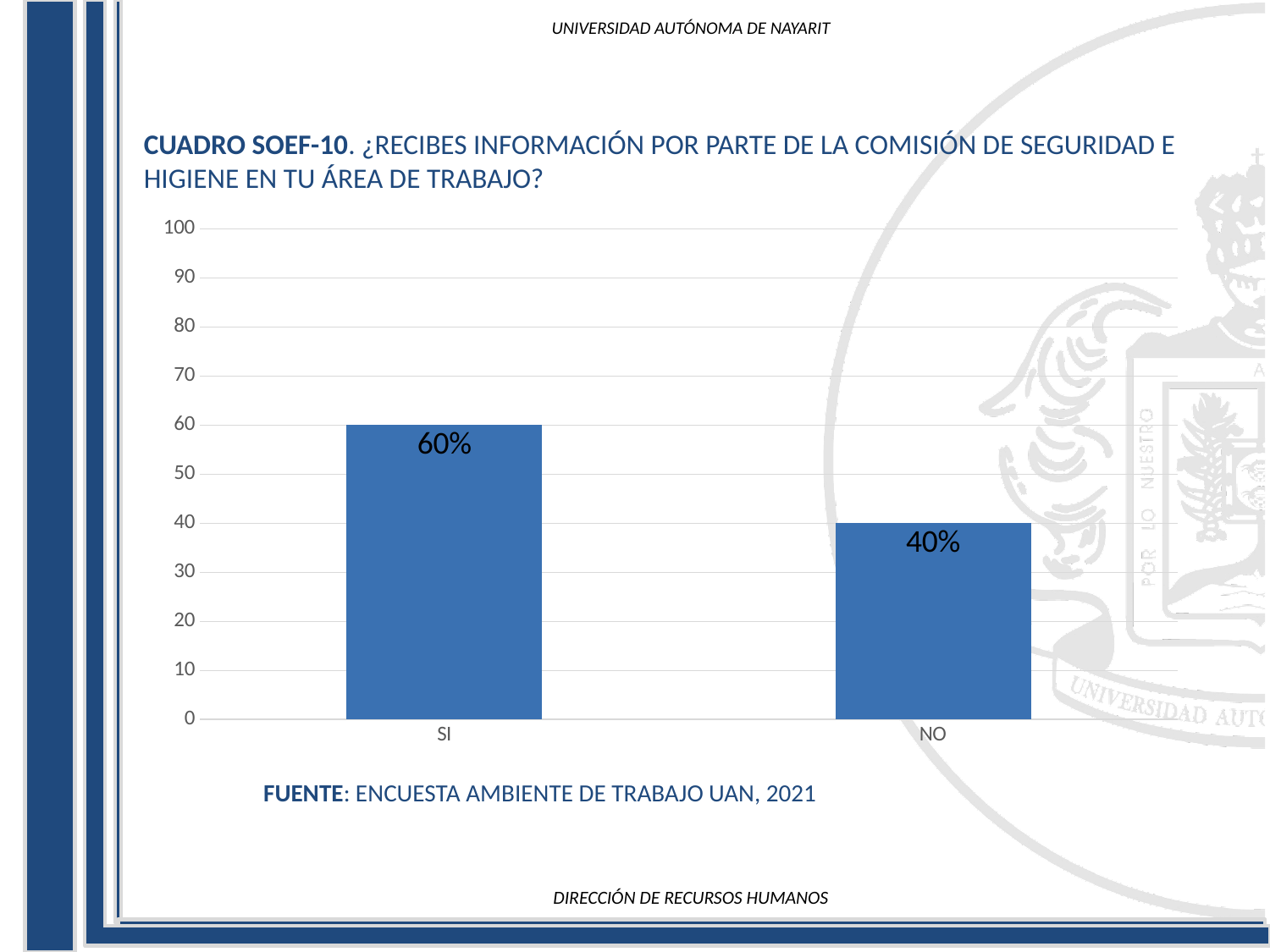
What is the value for NO? 40% What kind of chart is shown on the slide? bar chart Is the value for NO greater or less than 50? less What is the value for SI? 60% How many categories are shown on the x axis? 2 Which category has the lowest value? NO What source is cited below the chart? ENCUESTA AMBIENTE DE TRABAJO UAN, 2021 What is the maximum value shown on the y axis? 100 Is the value for SI greater or less than 50? greater What is the difference between the values for SI and NO? 20% Which category has the highest value? SI Which is larger, the value for SI or the value for NO? SI